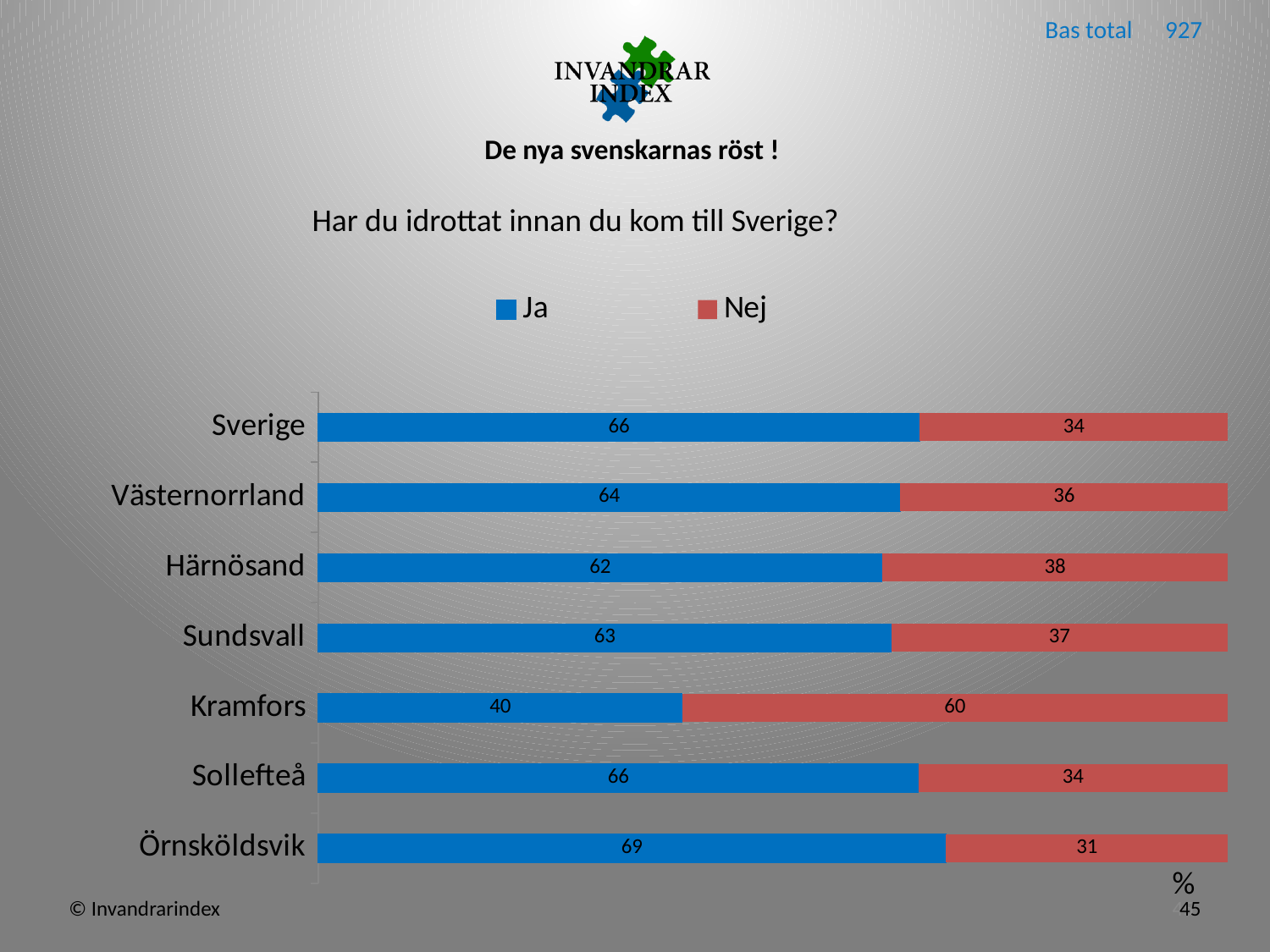
Which category has the highest "Ja" value? Örnsköldsvik How many categories are shown on the chart? 7 Which is larger: the "Ja" value for Sundsvall or the "Ja" value for Kramfors? Sundsvall What is the difference between the "Nej" values for Kramfors and Sverige? 26 What question is the chart about, as shown in the title? Har du idrottat innan du kom till Sverige? What is the "Ja" value for Kramfors? 40 What is the total of the stacked bar for Västernorrland? 100 Which category has the lowest "Ja" value? Kramfors What kind of chart is shown on the slide? Stacked bar chart How many series does the legend list? 2 What is the "Nej" value for Härnösand? 38 What is the "Ja" value for Örnsköldsvik? 69